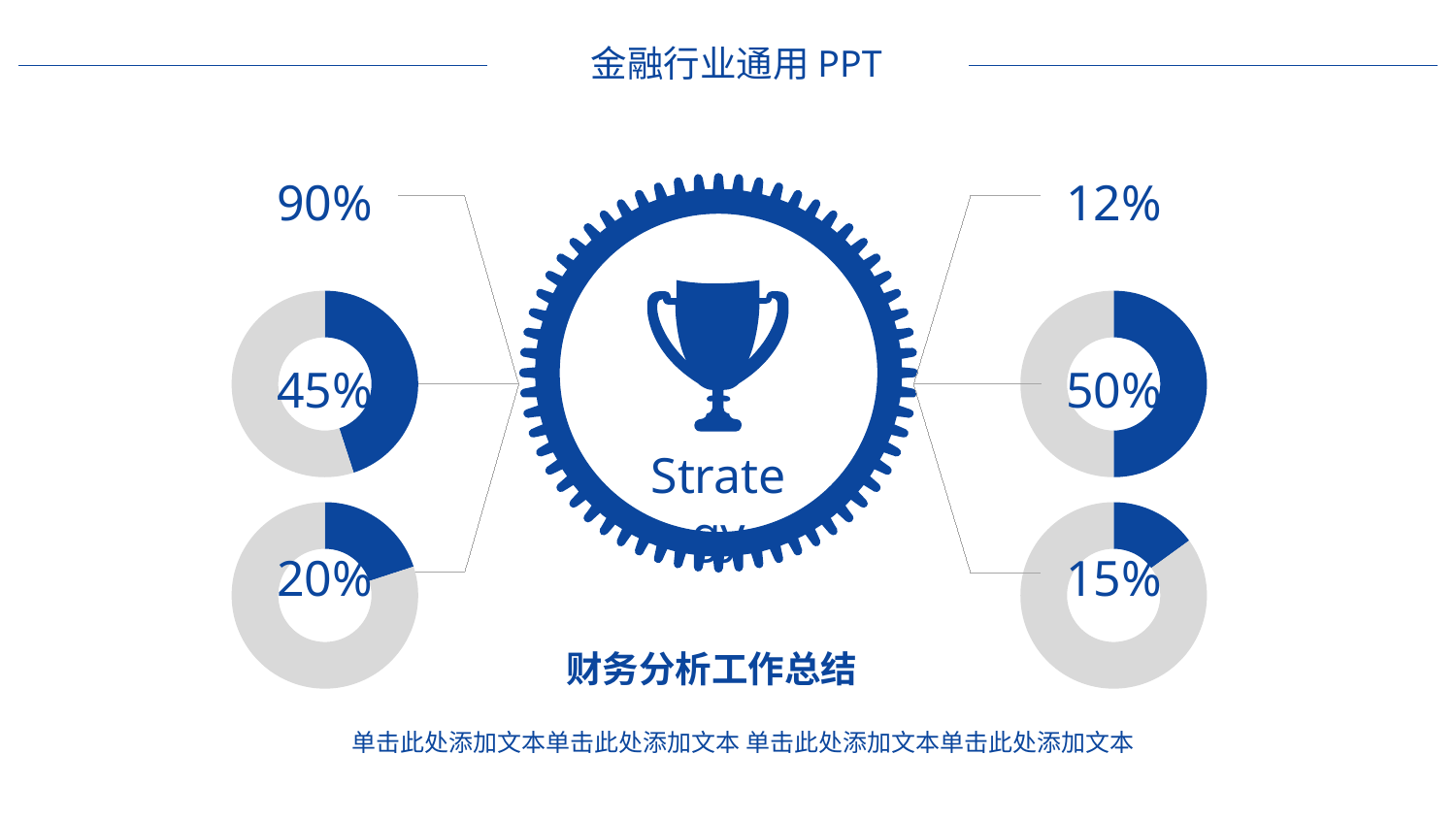
What colour is used for the filled portion of the donut charts? blue What percentage is shown in the top-left donut chart? 45% Which is larger, the percentage in the top-left donut chart or the bottom-left donut chart? top-left (45%) What is the difference between the percentages in the top-right and bottom-right donut charts? 35% Which donut chart shows the lowest percentage? bottom-right (15%) What kind of chart is the top-left chart on the slide? donut chart What percentage is shown in the bottom-right donut chart? 15% What percentage is shown in the top-right donut chart? 50% Which donut chart shows the highest percentage? top-right (50%) What percentage is shown in the bottom-left donut chart? 20% How many donut charts are on the slide? 4 What is the difference between the percentages in the top-left and bottom-left donut charts? 25%